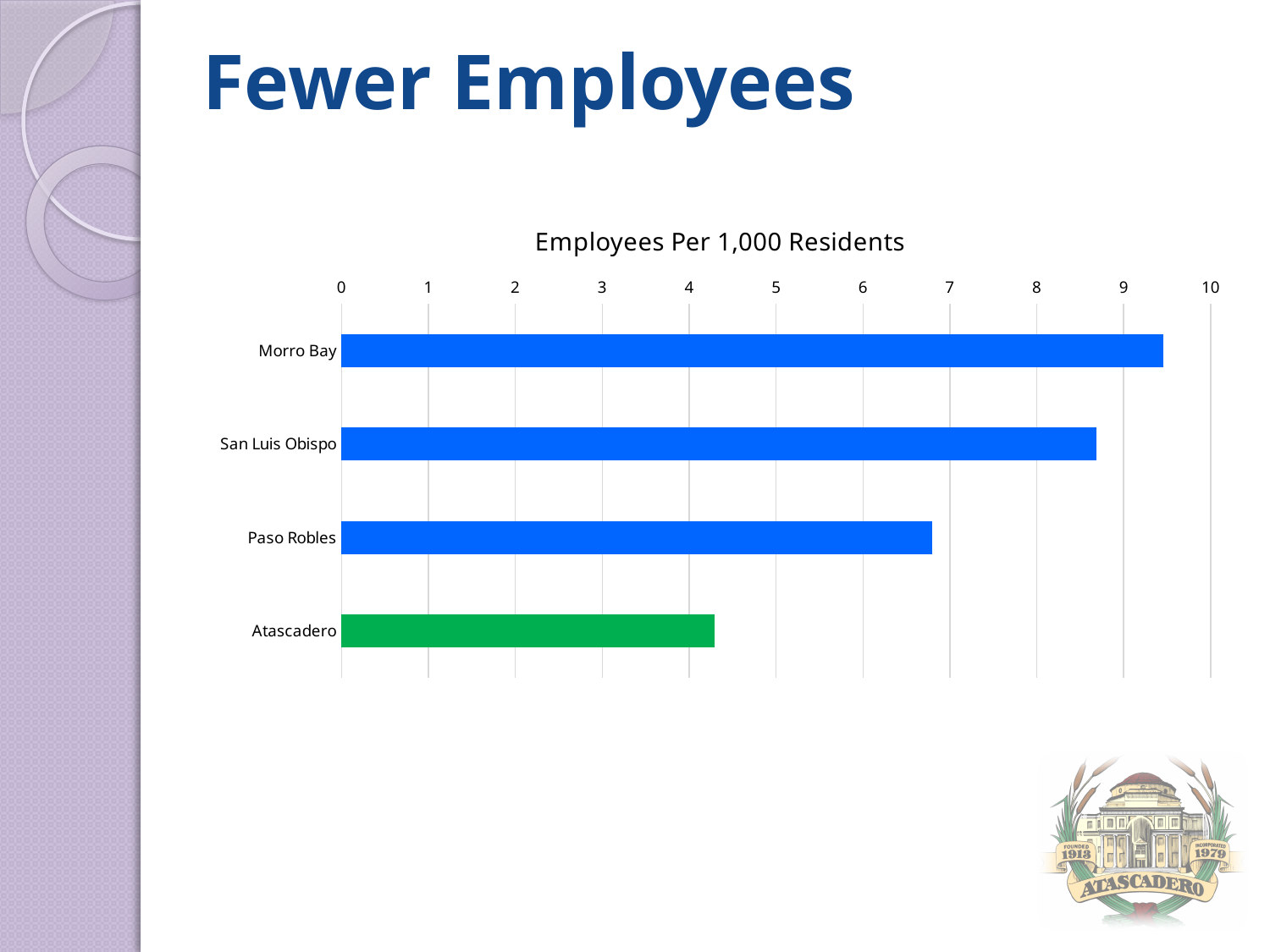
What type of chart is shown on the slide? bar chart Which city's bar is coloured green rather than blue? Atascadero Is the value for Atascadero greater or less than 5? less Which city has the lowest number of employees per 1,000 residents? Atascadero How many cities are shown in the chart? 4 Which has more employees per 1,000 residents, Paso Robles or Atascadero? Paso Robles Which has more employees per 1,000 residents, San Luis Obispo or Paso Robles? San Luis Obispo Which city has the highest number of employees per 1,000 residents? Morro Bay What is the title of the chart? Employees Per 1,000 Residents Is the value for Paso Robles greater or less than 6? greater Is the value for San Luis Obispo greater or less than 9? less